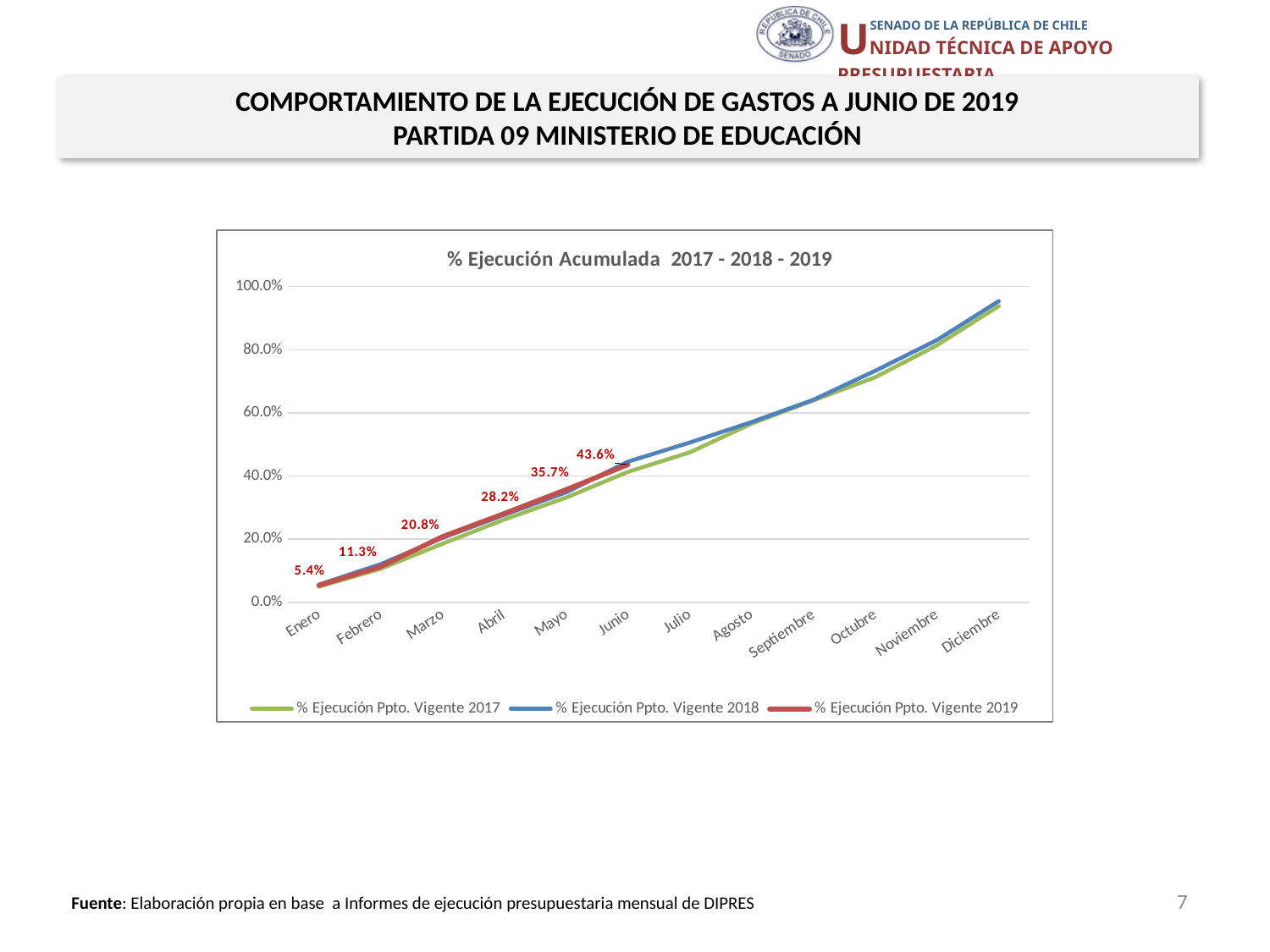
What is the value of % Ejecución Ppto. Vigente 2019 for Enero? 5.4% What is the value of % Ejecución Ppto. Vigente 2019 for Marzo? 20.8% What kind of chart is shown on the slide? line chart Is the value of % Ejecución Ppto. Vigente 2018 for Diciembre greater or less than 80.0%? greater What is the title of the chart? % Ejecución Acumulada 2017 - 2018 - 2019 What is the value of % Ejecución Ppto. Vigente 2019 for Junio? 43.6% What is the difference between the 2019 values for Abril and Febrero? 16.9% Do the values of the 2019 series rise or fall from Enero to Junio? rise How many series does the legend list? 3 What is the difference between the 2019 values for Junio and Mayo? 7.9% How many months are shown on the x axis? 12 Is the value of % Ejecución Ppto. Vigente 2017 for Julio greater or less than 60.0%? less